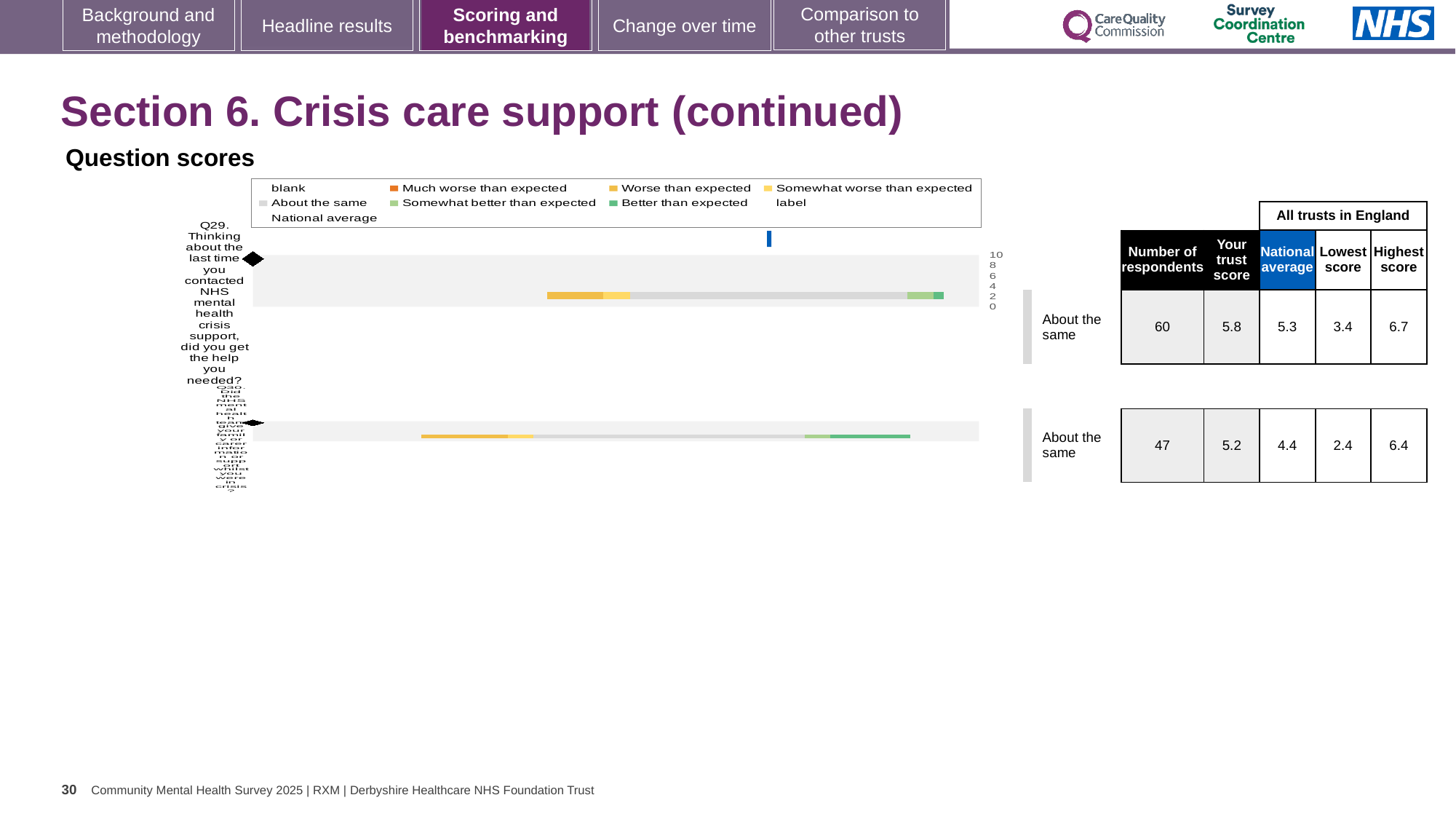
How many respondents answered Q29? 60 How many entries does the legend of the question scores chart list? 9 How many questions are plotted in the question scores chart? 2 For Q29, what is the difference between the highest score and the lowest score among all trusts in England? 3.3 What is the national average for Q30? 4.4 What benchmark category is shown for Q29 in the question scores chart? About the same What kind of chart is used to show the question scores on this slide? bar chart For Q29, which is larger: the trust score or the national average? trust score What is the trust score for Q29 (Thinking about the last time you contacted NHS mental health crisis support, did you get the help you needed?)? 5.8 What is the national average for Q29? 5.3 What is the lowest score among all trusts in England for Q30? 2.4 What is the trust score for Q30? 5.2